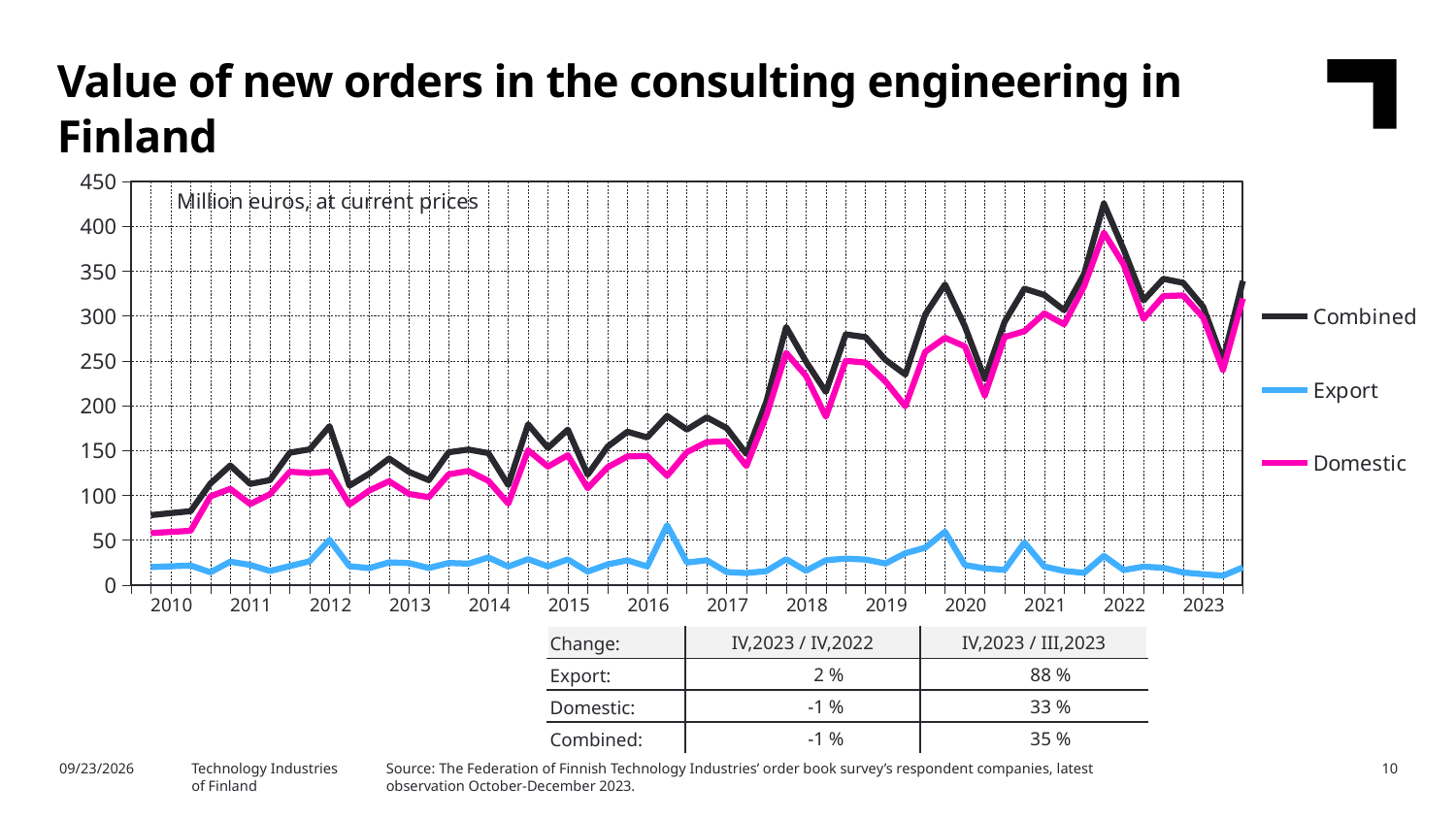
What colour is the Export line? blue Is the peak value of the Domestic series (around late 2021) greater or less than 350? greater How many years are labelled on the x axis? 14 Is the Export value at the start of 2010 greater or less than 50? less What are the three series named in the legend? Combined, Export, Domestic Does the Combined series generally rise or fall from 2010 to 2023? rise According to the table below the chart, what is the Export change for IV,2023 / III,2023? 88 % Is the peak value of the Combined series (around late 2021) greater or less than 400? greater Which series has the highest values throughout the chart? Combined Which series has the lowest values throughout the chart? Export How many series does the legend list? 3 What type of chart is shown on the slide? line chart